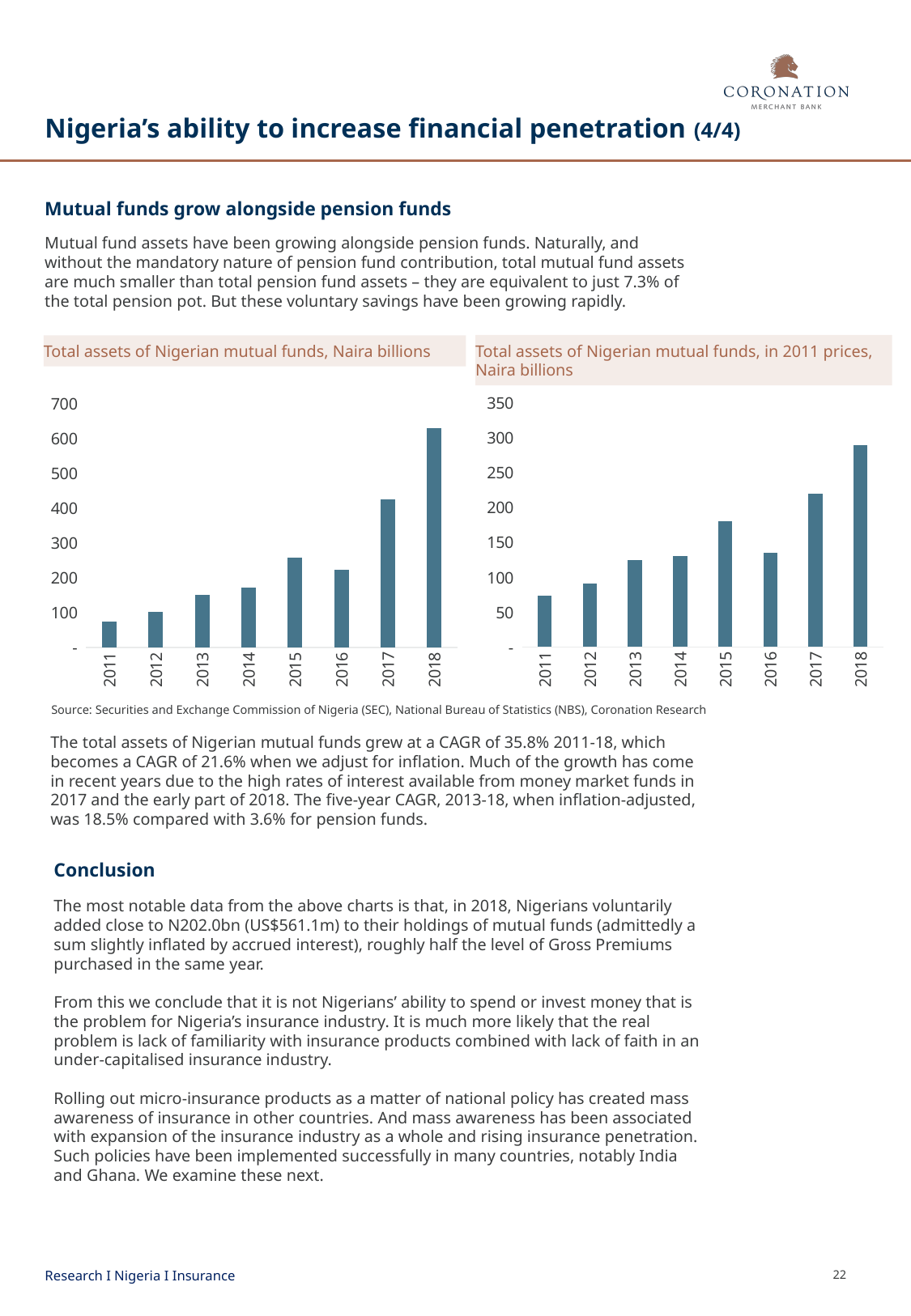
In the right chart, 'Total assets of Nigerian mutual funds, in 2011 prices, Naira billions', which year has the lowest value? 2011 In the right chart, 'Total assets of Nigerian mutual funds, in 2011 prices, Naira billions', which year has the larger value, 2015 or 2016? 2015 In the left chart, 'Total assets of Nigerian mutual funds, Naira billions', how many years are plotted? 8 In the right chart, 'Total assets of Nigerian mutual funds, in 2011 prices, Naira billions', is the value for 2012 greater or less than 100? less In the left chart, 'Total assets of Nigerian mutual funds, Naira billions', is the value for 2017 greater or less than 400? greater In the right chart, 'Total assets of Nigerian mutual funds, in 2011 prices, Naira billions', is the value for 2017 greater or less than 200? greater In the left chart, 'Total assets of Nigerian mutual funds, Naira billions', which year has the larger value, 2015 or 2016? 2015 In the right chart, 'Total assets of Nigerian mutual funds, in 2011 prices, Naira billions', which year has the highest value? 2018 In the left chart, 'Total assets of Nigerian mutual funds, Naira billions', what kind of chart is shown? Bar chart In the left chart, 'Total assets of Nigerian mutual funds, Naira billions', which year has the highest value? 2018 In the left chart, 'Total assets of Nigerian mutual funds, Naira billions', which year has the lowest value? 2011